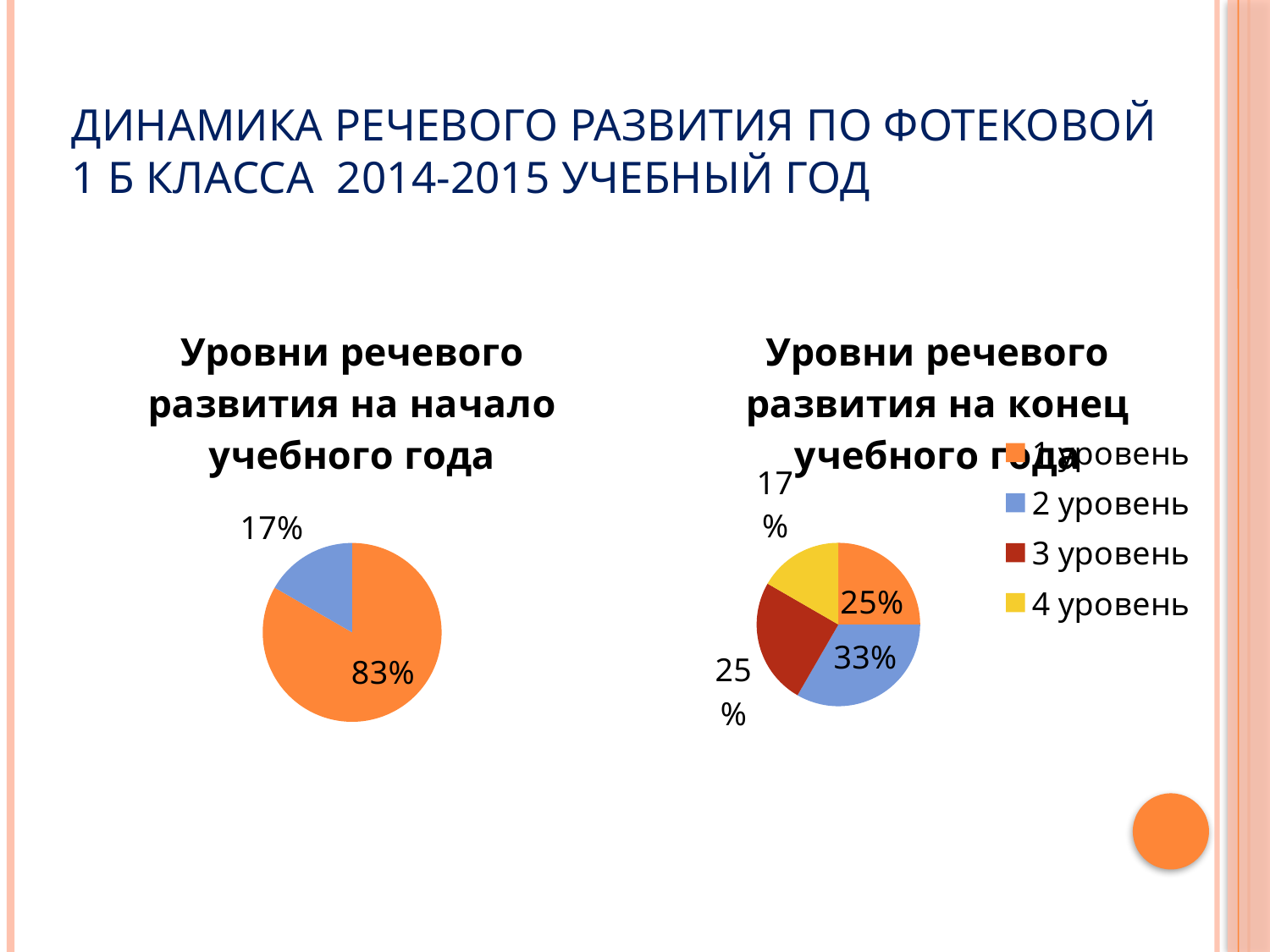
In the 'Уровни речевого развития на начало учебного года' chart, how many slices does the pie have? 2 In the 'Уровни речевого развития на начало учебного года' chart, what share does the orange slice have? 83% How many entries does the legend of the 'Уровни речевого развития на конец учебного года' chart list? 4 In the 'Уровни речевого развития на конец учебного года' chart, which level has the smallest share? 4 уровень In the 'Уровни речевого развития на конец учебного года' chart, what share does '4 уровень' have? 17% What kind of chart is the 'Уровни речевого развития на начало учебного года' chart? pie chart In the 'Уровни речевого развития на конец учебного года' chart, which is larger: '2 уровень' or '3 уровень'? 2 уровень In the 'Уровни речевого развития на начало учебного года' chart, what share does the blue slice have? 17% In the 'Уровни речевого развития на конец учебного года' chart, what share does '1 уровень' have? 25% In the 'Уровни речевого развития на конец учебного года' chart, which level has the largest share? 2 уровень In the 'Уровни речевого развития на начало учебного года' chart, what is the difference between the orange slice and the blue slice? 66% In the 'Уровни речевого развития на конец учебного года' chart, what share does '2 уровень' have? 33%